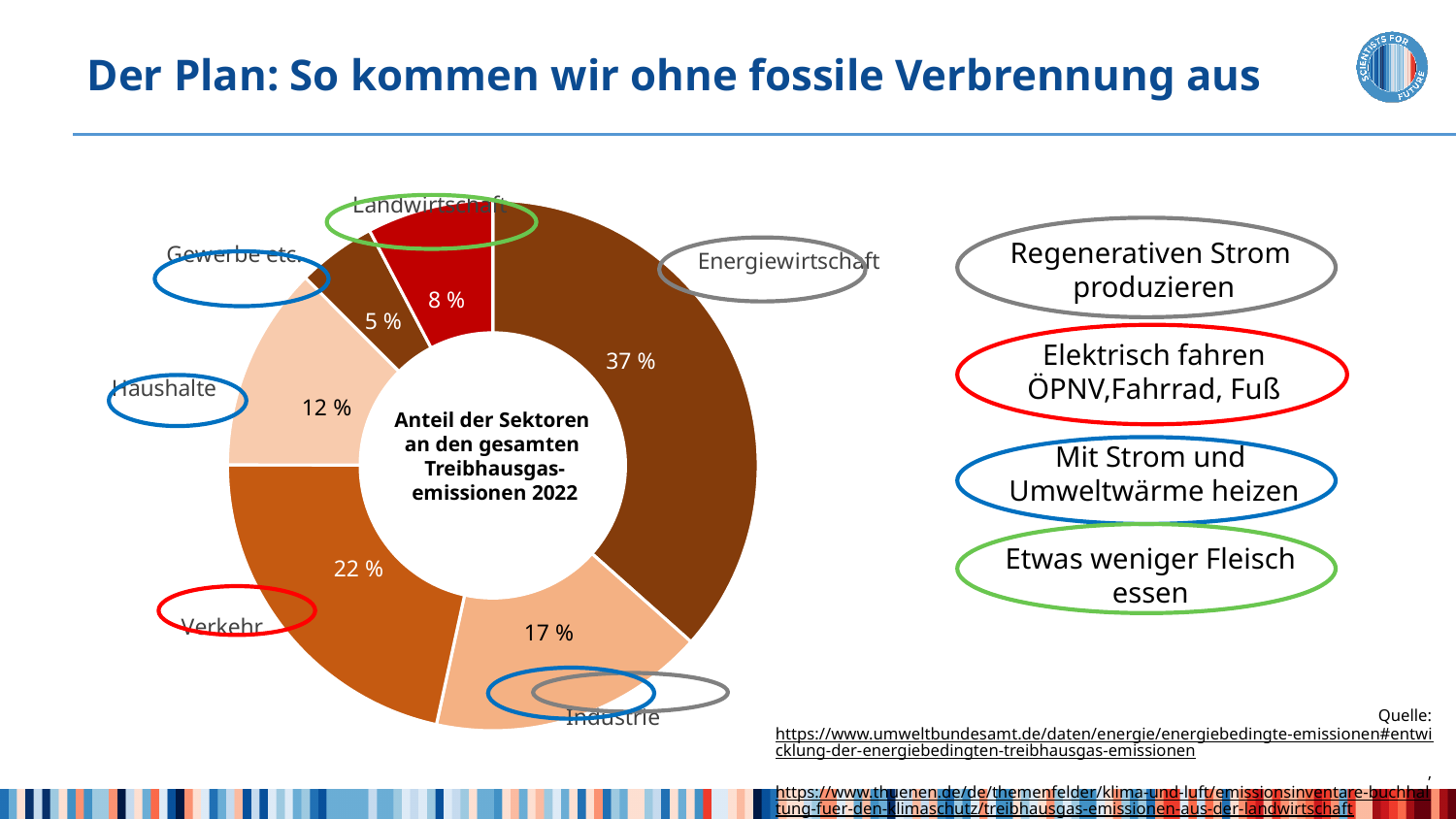
Which sector has the largest share of emissions? Energiewirtschaft What share is shown for Verkehr? 22 % What share is shown for Haushalte? 12 % What share of total greenhouse gas emissions does Energiewirtschaft have? 37 % What share is shown for Industrie? 17 % What share is shown for Landwirtschaft? 8 % Which has the larger share, Haushalte or Landwirtschaft? Haushalte Which sector has the smallest share of emissions? Gewerbe etc. What kind of chart is shown on the slide? Doughnut (pie) chart What is the title printed in the centre of the chart? Anteil der Sektoren an den gesamten Treibhausgas-emissionen 2022 How many percentage points larger is the share of Verkehr than the share of Industrie? 5 % How many sectors are shown in the chart? 6